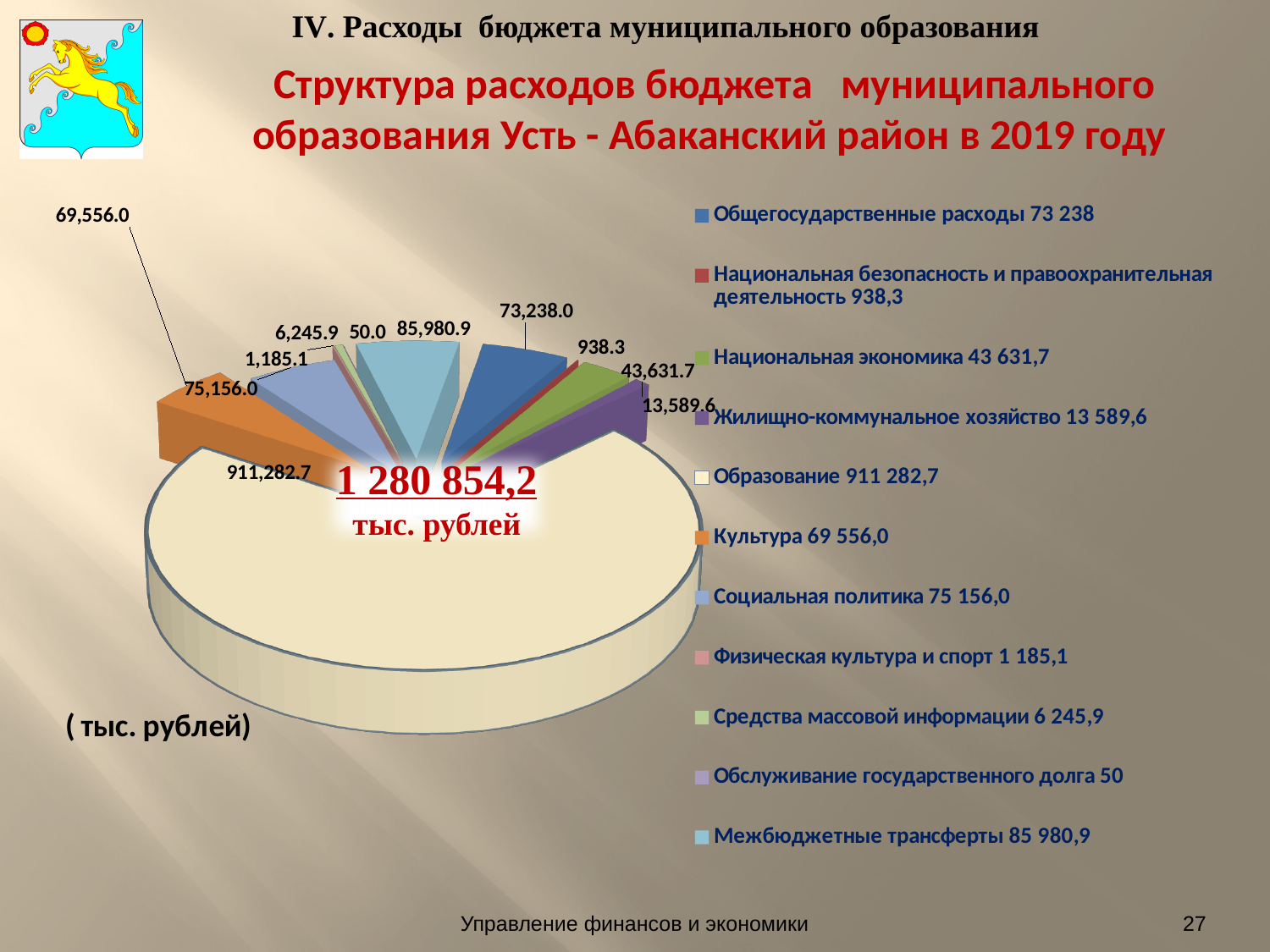
Which category has the smallest value in the pie chart? Обслуживание государственного долга What is the difference between Социальная политика (75,156.0) and Культура (69,556.0)? 5,600.0 What is the value shown for Жилищно-коммунальное хозяйство? 13,589.6 What total amount is printed in the centre of the pie chart? 1 280 854,2 тыс. рублей What is the value shown for Образование? 911,282.7 What is the difference between Межбюджетные трансферты (85,980.9) and Общегосударственные расходы (73,238.0)? 12,742.9 Which category has the largest share of the pie? Образование What is the value shown for Межбюджетные трансферты? 85,980.9 How many categories does the legend of the pie chart list? 11 What kind of chart is shown on the slide? Pie chart In what units are the values of the pie chart given, according to the slide? тыс. рублей Which is larger: Национальная экономика or Жилищно-коммунальное хозяйство? Национальная экономика